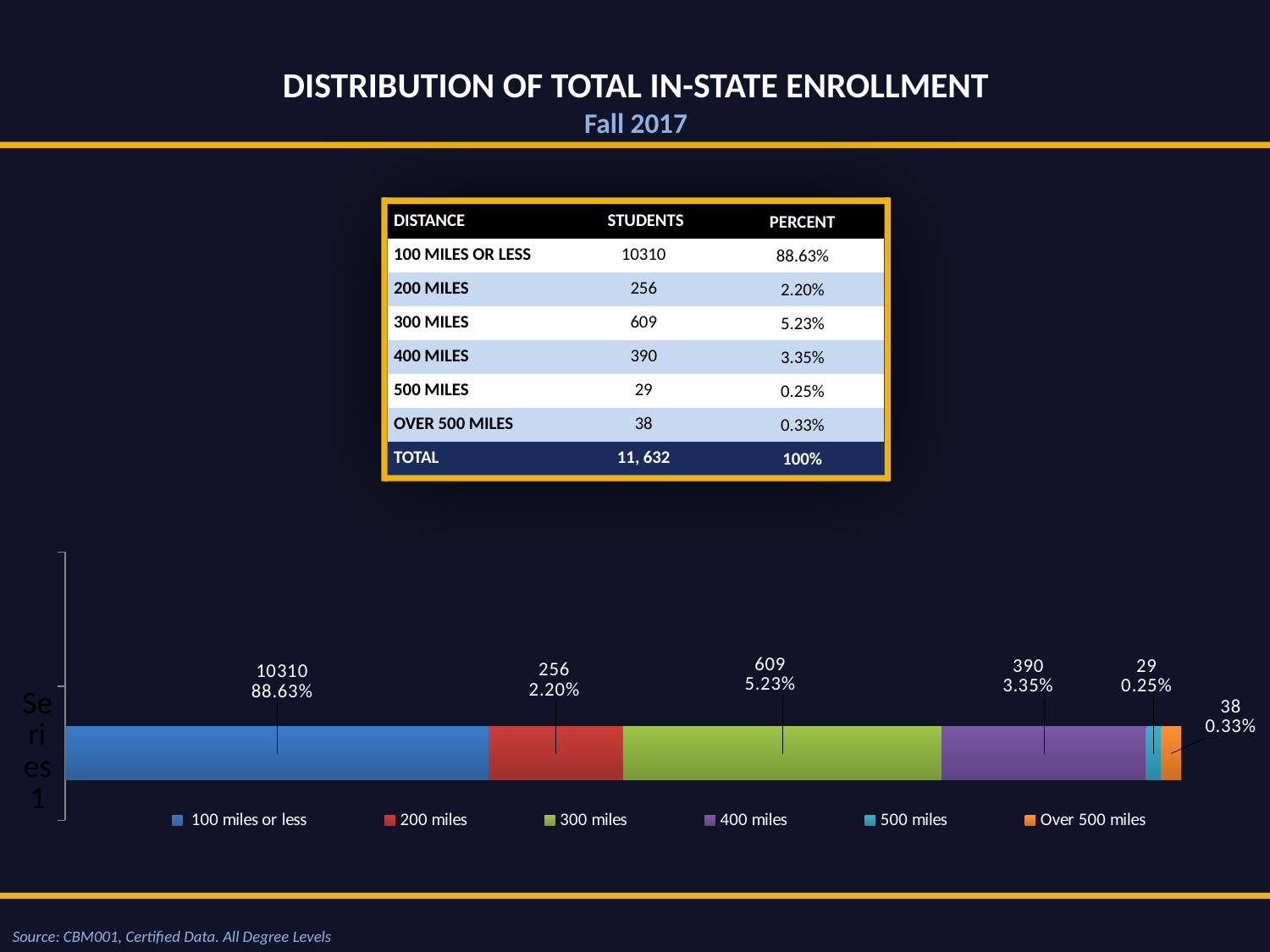
What colour is the 300 miles segment in the chart? green What percentage is labelled on the 300 miles segment of the bar? 5.23% What value is labelled on the 400 miles segment of the bar? 390 What is the difference between the 300 miles value and the 200 miles value? 353 What is the total of all segments in the stacked bar? 11632 What percentage is labelled on the Over 500 miles segment? 0.33% How many series does the chart legend list? 6 Which is larger, the 400 miles value or the 200 miles value? 400 miles Which segment of the bar has the highest value? 100 miles or less Which segment of the bar has the lowest value? 500 miles What is the number of students shown for the 100 miles or less segment of the bar? 10310 What kind of chart is shown on the slide? bar chart